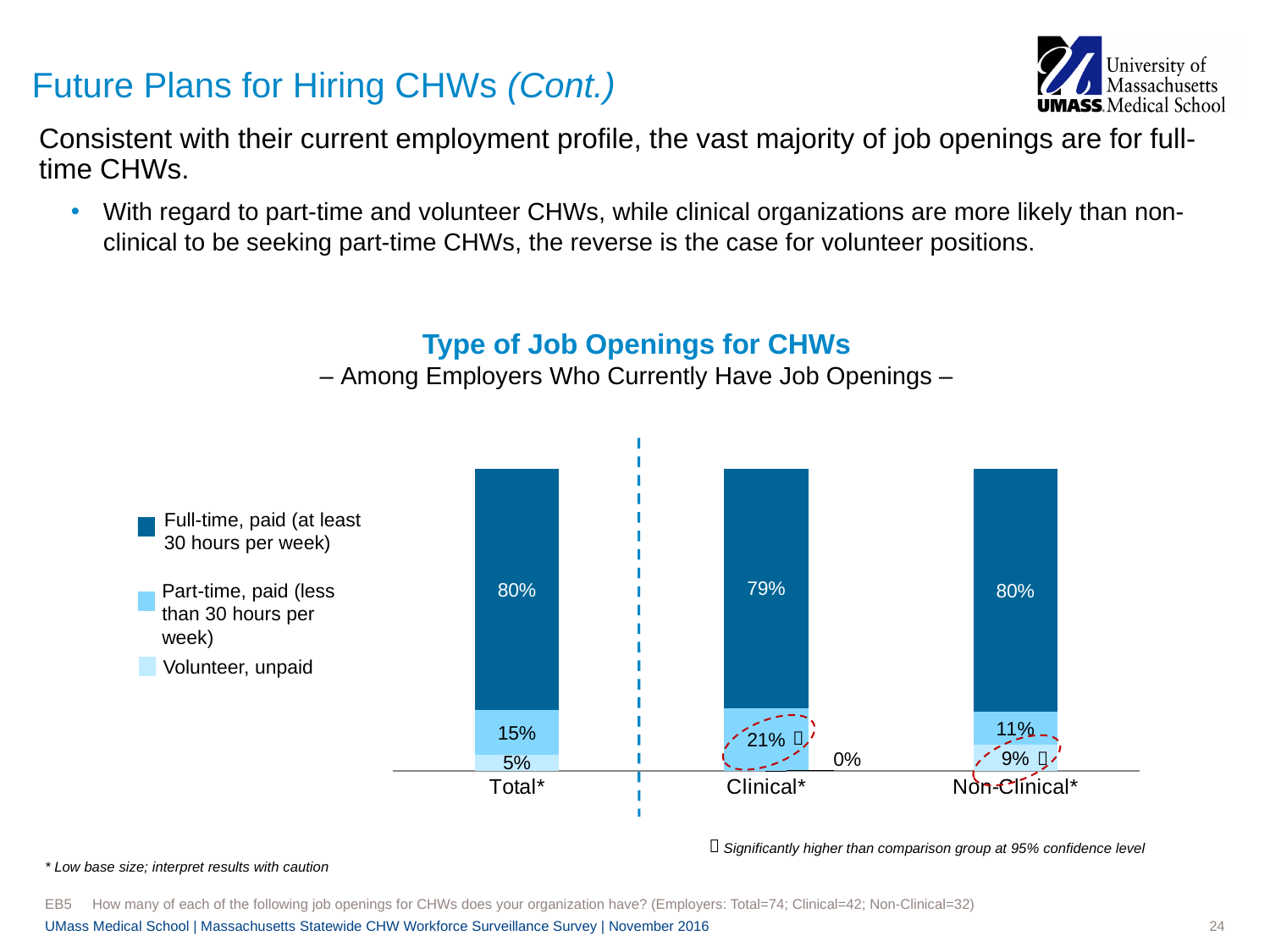
What percentage of job openings for Non-Clinical employers are volunteer, unpaid? 9% What percentage of job openings for Clinical employers are volunteer, unpaid? 0% What is the difference between the part-time, paid share for Clinical and Non-Clinical employers? 10 percentage points How many series does the legend list? 3 What is the title of the chart? Type of Job Openings for CHWs How many employer groups are shown on the x axis? 3 Which group has the highest share of part-time, paid job openings? Clinical* What percentage of job openings for the Total group are full-time, paid? 80% Which group has the lowest share of volunteer, unpaid job openings? Clinical* Which is larger: the volunteer, unpaid share for Non-Clinical or for Total? Non-Clinical What type of chart is shown on the slide? Stacked bar chart What percentage of job openings for Clinical employers are part-time, paid? 21%